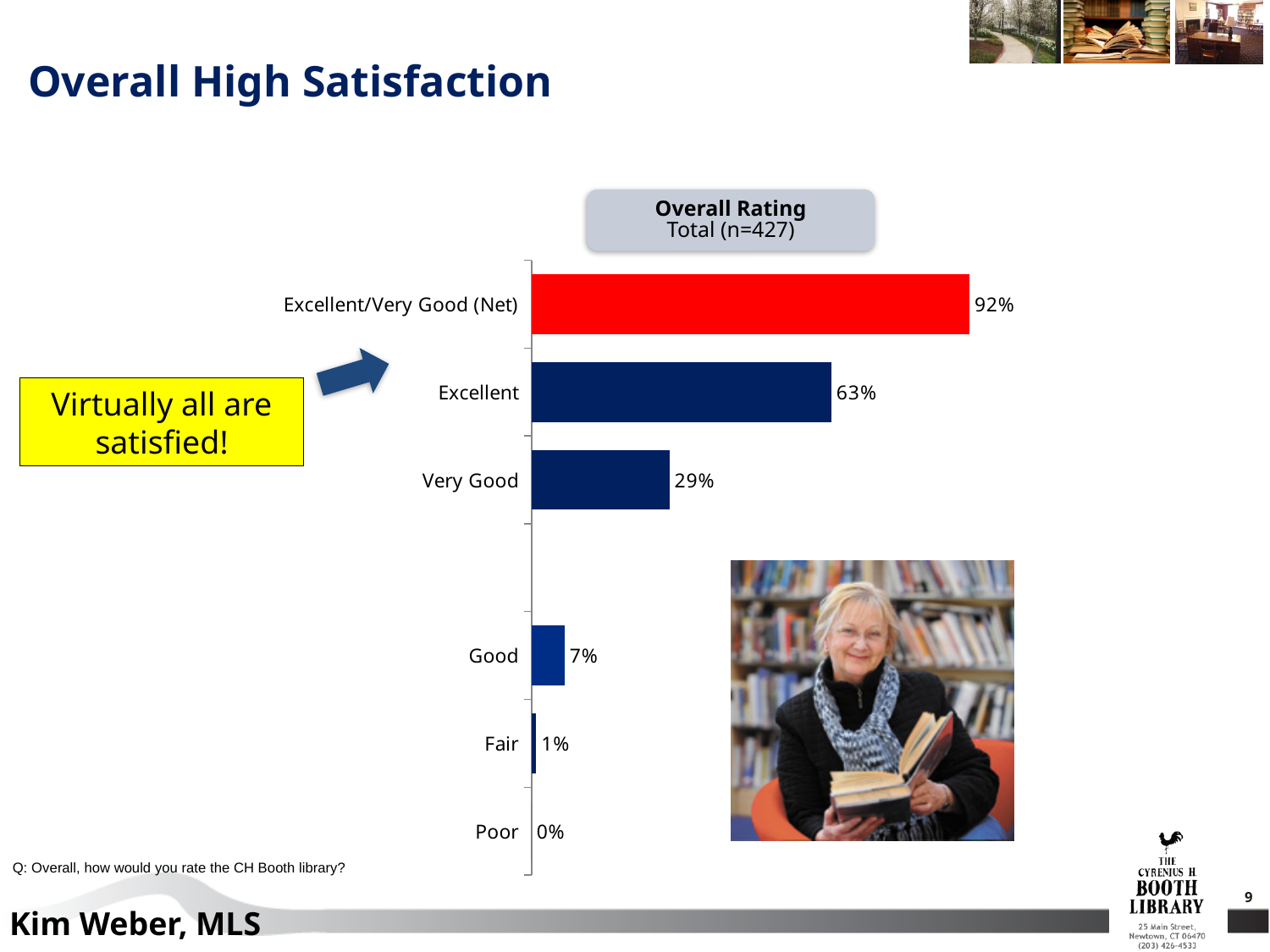
What is the value shown for Very Good? 29% What percentage of respondents rated the library Excellent? 63% What percentage rated the library Fair? 1% How many rating categories are shown on the chart, including the Net bar? 6 What is the sample size (n) shown in the chart header? 427 Which is larger, the value for Good or the value for Fair? Good Which individual rating category (excluding the Net bar) has the highest value? Excellent What is the value for the Excellent/Very Good (Net) bar? 92% Which rating category has the lowest value? Poor What is the difference between the Excellent and Very Good percentages? 34% What type of chart is shown on the slide? Bar chart What colour is the Excellent/Very Good (Net) bar? Red